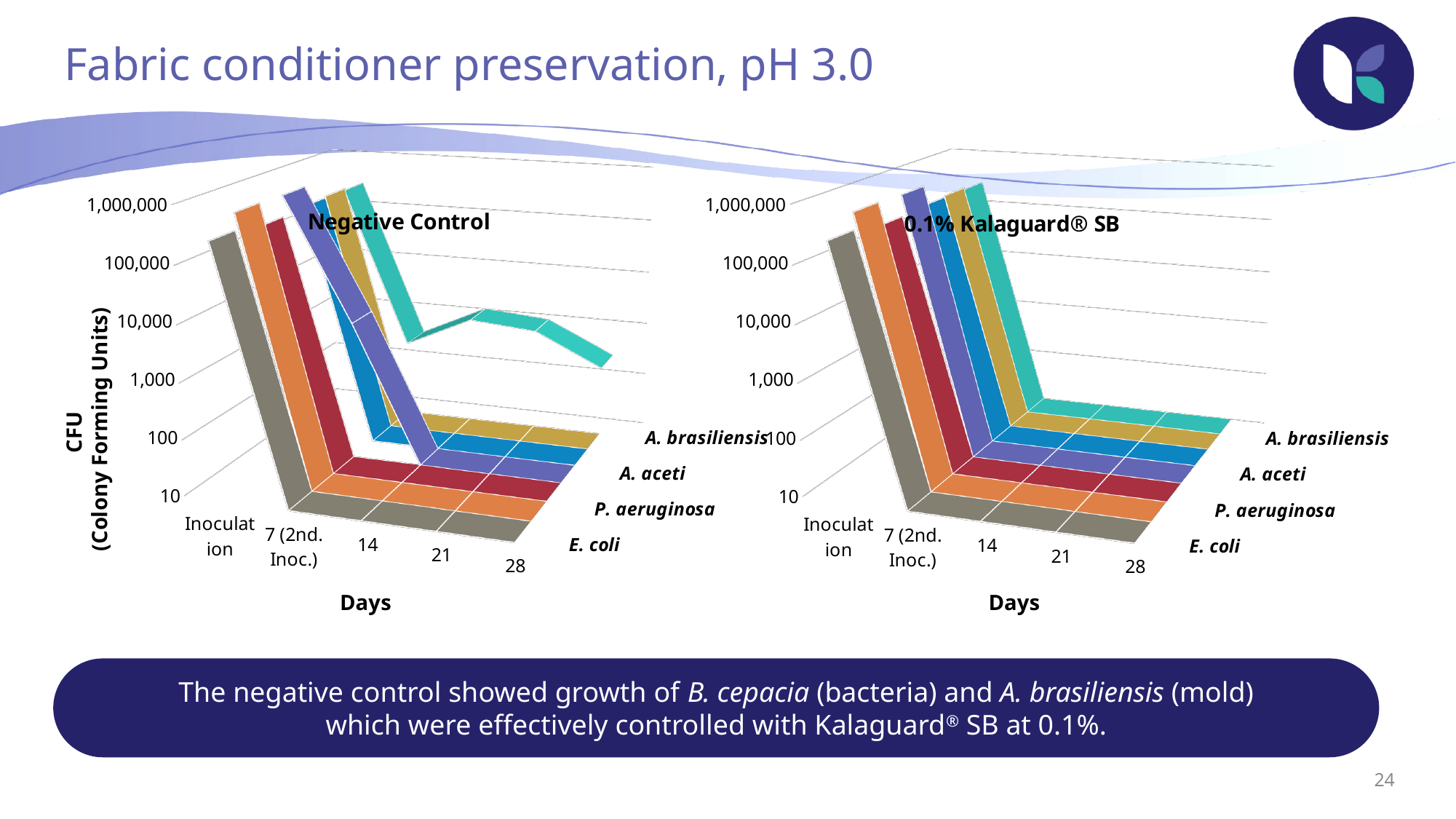
In the Negative Control chart, which series has the highest value at day 28? A. brasiliensis What is the highest tick value shown on the y axis of the 0.1% Kalaguard® SB chart? 1,000,000 In the 0.1% Kalaguard® SB chart, do the A. brasiliensis values rise or fall from Inoculation to day 14? fall How many charts are shown on the slide? 2 In the Negative Control chart, do the E. coli values rise or fall from Inoculation to day 14? fall How many time points are shown on the Days axis of the 0.1% Kalaguard® SB chart? 5 In the Negative Control chart, which is larger at day 28: A. brasiliensis or E. coli? A. brasiliensis What kind of chart is the Negative Control chart? 3D line chart What is the first category on the Days axis of the Negative Control chart? Inoculation What is the x-axis title of the Negative Control chart? Days What is the label of the y axis on the Negative Control chart? CFU (Colony Forming Units)